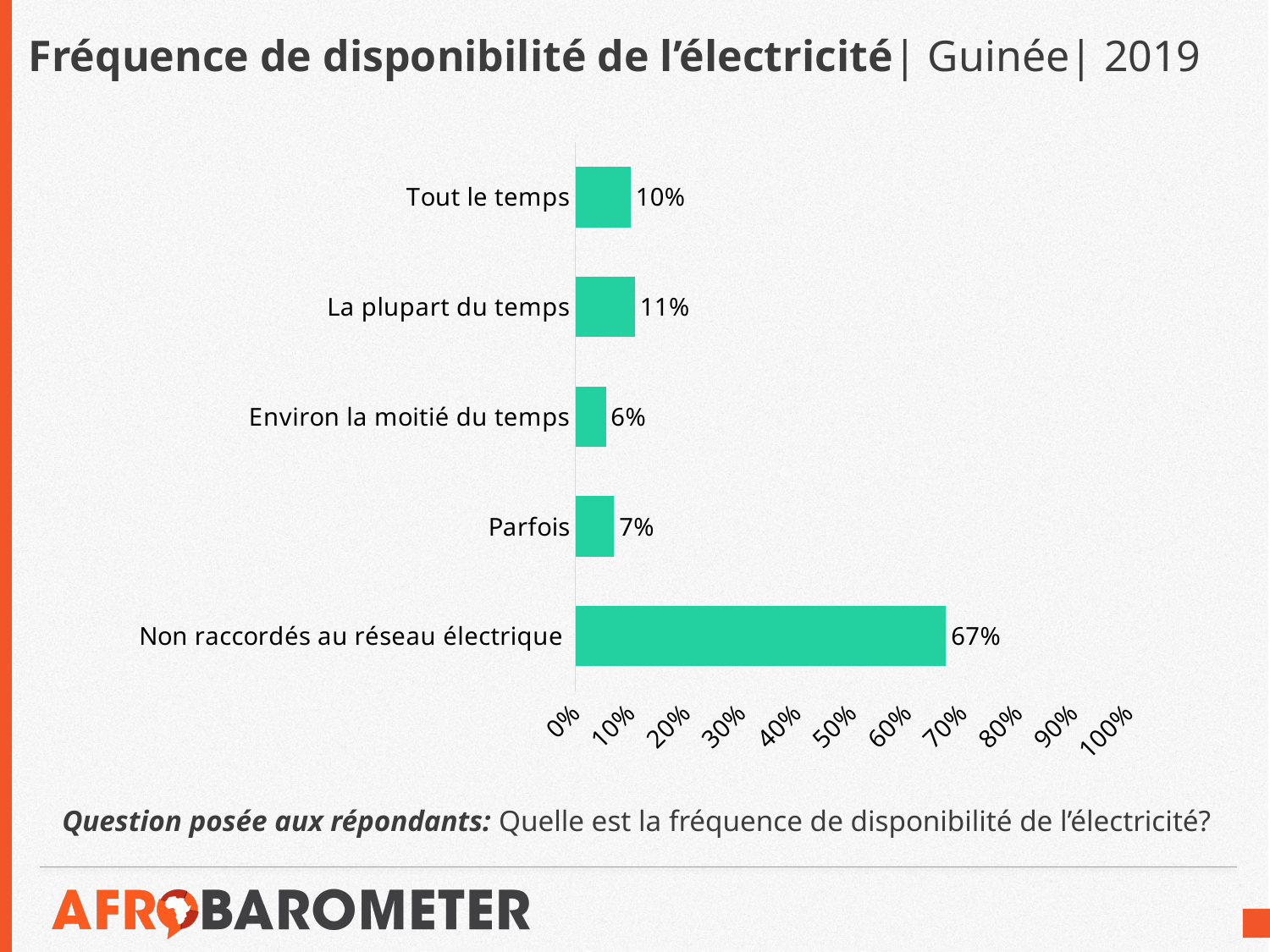
What is the value for 'Parfois'? 7% Which category has the highest value? Non raccordés au réseau électrique Which category has the lowest value? Environ la moitié du temps What type of chart is shown on the slide? Bar chart What percentage of respondents said electricity is available 'Tout le temps'? 10% What is the difference between 'Non raccordés au réseau électrique' and 'La plupart du temps'? 56 percentage points Which is larger: 'Tout le temps' or 'La plupart du temps'? La plupart du temps What percentage is shown for 'Environ la moitié du temps'? 6% How many categories are shown in the chart? 5 What is the value shown for 'Non raccordés au réseau électrique'? 67% Which country and year does the chart title refer to? Guinée, 2019 Is the value for 'Non raccordés au réseau électrique' greater or less than 60%? greater